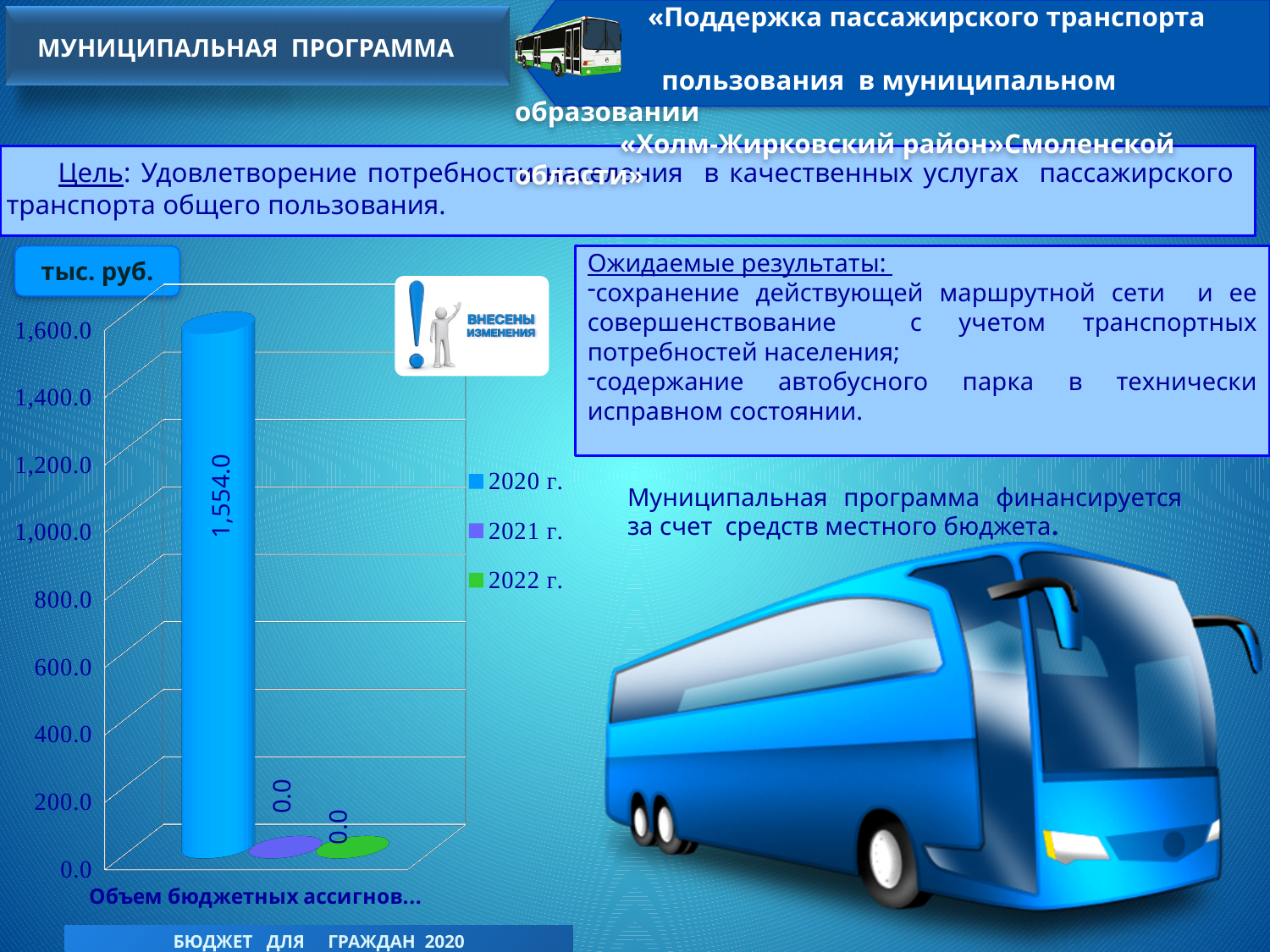
Is the value for 2020 г. greater or less than 1,400.0? greater Which year has the highest value in the chart? 2020 г. How many series does the chart legend list? 3 What kind of chart is shown on the slide? bar chart Which is larger, the value for 2020 г. or the value for 2022 г.? 2020 г. What unit is shown above the chart's vertical axis? тыс. руб. What is the value for 2020 г. in the chart? 1,554.0 What is the value for 2021 г. in the chart? 0.0 Is the value for 2020 г. greater or less than 1,600.0? less What is the difference between the values for 2020 г. and 2021 г.? 1,554.0 What is the value for 2022 г. in the chart? 0.0 What colour is the bar for 2020 г. in the chart? blue